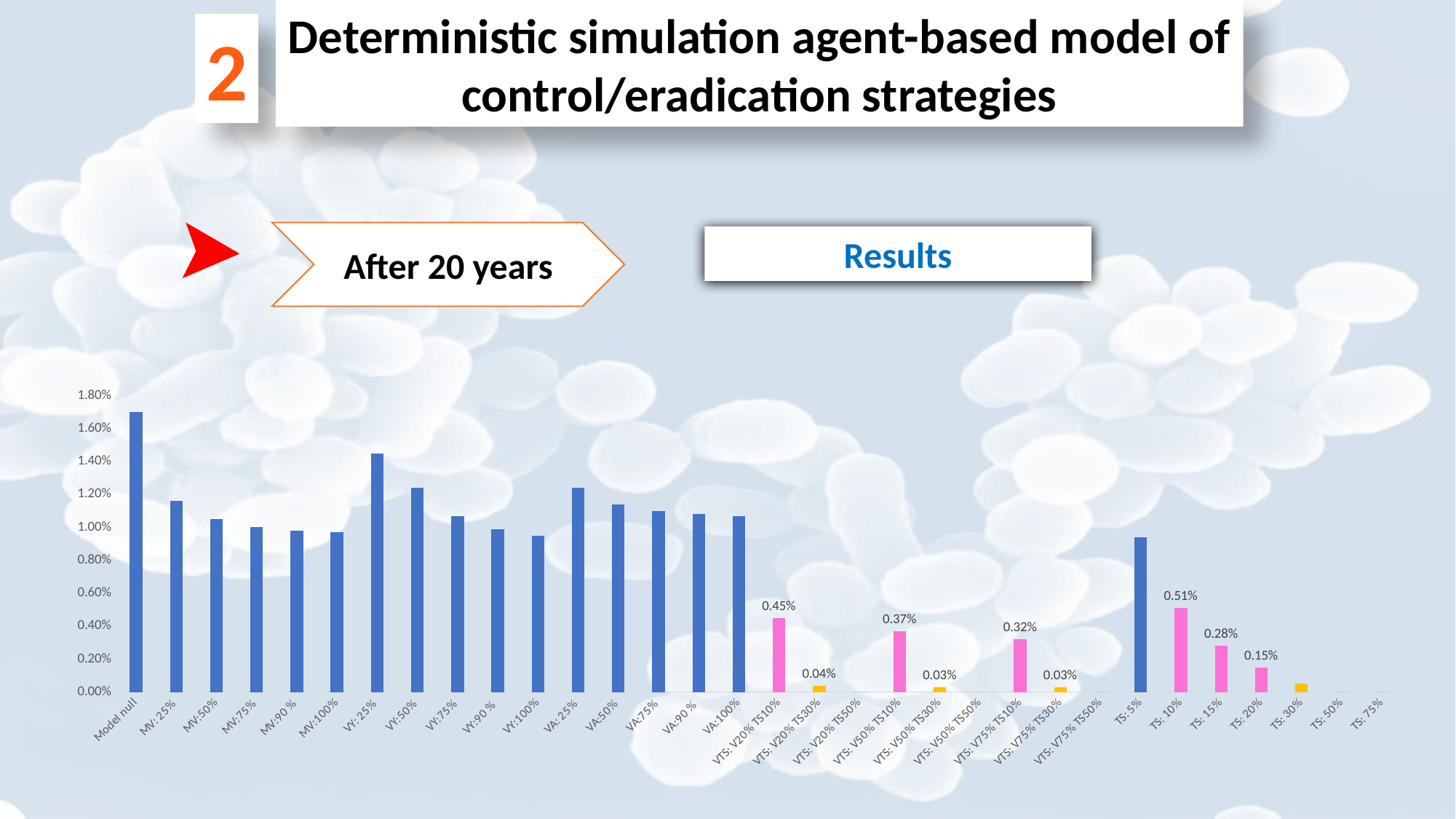
What is the value for TS: 20%? 0.15% What is the value for VTS: V75% TS10%? 0.32% What kind of chart is shown on the slide? bar chart What is the value for VTS: V20% TS10%? 0.45% What is the difference between the values for VTS: V20% TS10% and VTS: V50% TS10%? 0.08% What is the difference between the values for TS: 10% and TS: 15%? 0.23% Do the values rise or fall from TS: 5% to TS: 75% along the x axis? fall Which category has the highest value in the chart? Model null Which is larger, the value for VTS: V20% TS10% or the value for VTS: V75% TS10%? VTS: V20% TS10% What is the value for TS: 10%? 0.51% Is the value for TS: 5% greater or less than 1.00%? less Is the value for Model null greater or less than 1.60%? greater